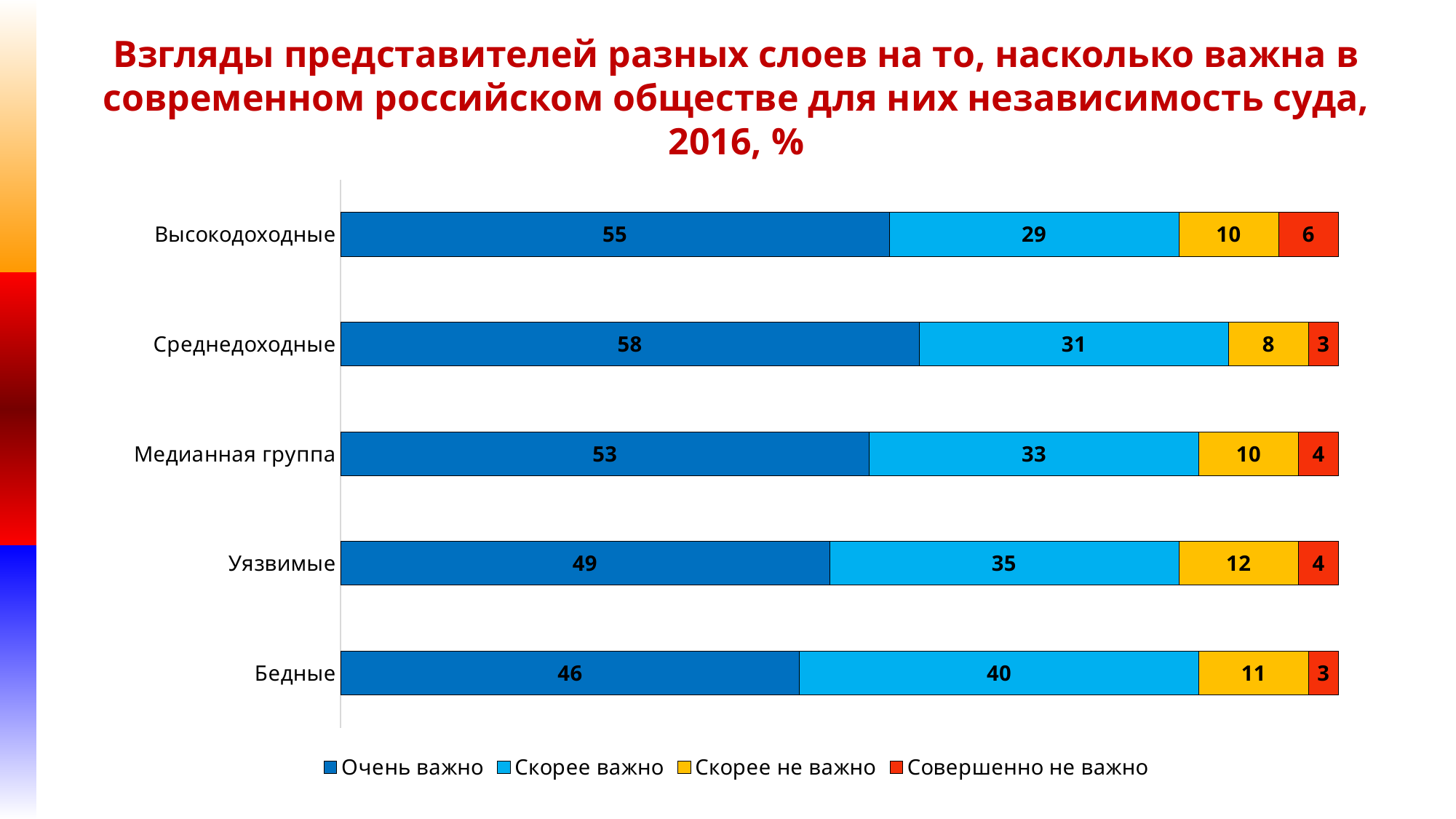
What is the total of the stacked bar for Медианная группа? 100 Which category has the lowest value for "Очень важно"? Бедные Which category has the highest value for "Совершенно не важно"? Высокодоходные How many categories are shown on the chart? 5 What kind of chart is shown on the slide? Stacked bar chart What is the value of "Совершенно не важно" for Среднедоходные? 3 How many series does the legend list? 4 Which category has the highest value for "Очень важно"? Среднедоходные What is the value of "Очень важно" for Высокодоходные? 55 What is the difference between the "Скорее важно" values for Бедные and Высокодоходные? 11 What is the value of "Скорее важно" for Бедные? 40 Which is larger: the "Скорее не важно" value for Уязвимые or for Среднедоходные? Уязвимые